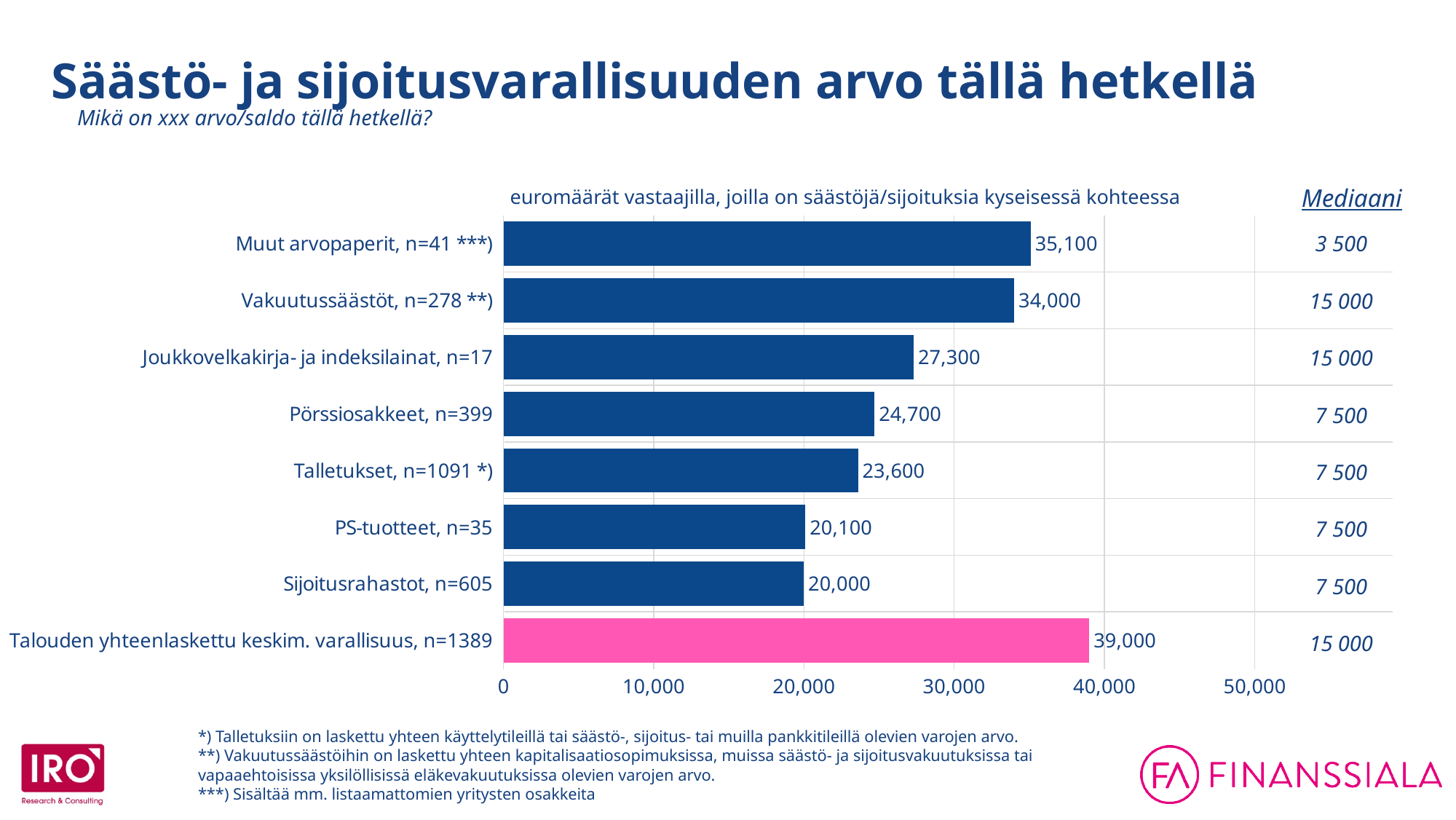
Which bar is coloured pink rather than dark blue? Talouden yhteenlaskettu keskim. varallisuus, n=1389 What is the Mediaani value listed for Muut arvopaperit, n=41 ***)? 3 500 Is the value for Joukkovelkakirja- ja indeksilainat, n=17 greater or less than 30,000? less What kind of chart is shown on the slide? bar chart How many categories are shown in the chart? 8 Which is larger, the value for Talletukset, n=1091 *) or the value for PS-tuotteet, n=35? Talletukset, n=1091 *) What is the difference between the values for Muut arvopaperit, n=41 ***) and Vakuutussäästöt, n=278 **)? 1,100 What is the value for Talouden yhteenlaskettu keskim. varallisuus, n=1389? 39,000 What is the value for Pörssiosakkeet, n=399? 24,700 Which category has the lowest value? Sijoitusrahastot, n=605 What is the value for Vakuutussäästöt, n=278 **)? 34,000 Which category has the highest value? Talouden yhteenlaskettu keskim. varallisuus, n=1389